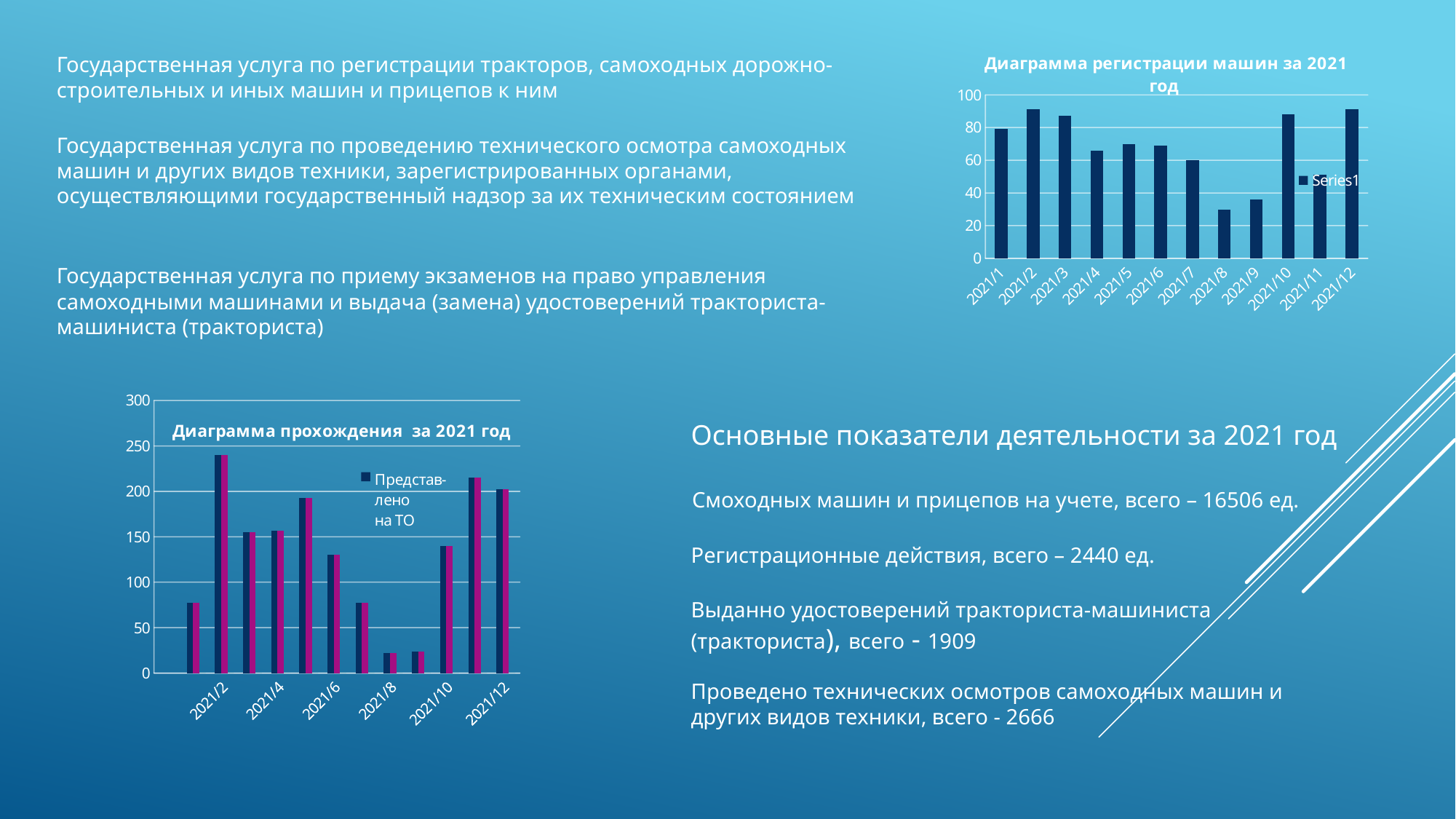
How many series does the legend of the 'Диаграмма регистрации машин за 2021 год' chart list? 1 What kind of chart is the 'Диаграмма прохождения за 2021 год' chart? bar chart In the 'Диаграмма регистрации машин за 2021 год' chart, which month has the lowest value? 2021/8 What legend entry is shown on the 'Диаграмма прохождения за 2021 год' chart? Представ-лено на ТО In the 'Диаграмма регистрации машин за 2021 год' chart, is the value for 2021/9 greater or less than 40? less In the 'Диаграмма прохождения за 2021 год' chart, is the value of the magenta bar for 2021/2 greater or less than 200? greater What kind of chart is the 'Диаграмма регистрации машин за 2021 год' chart? bar chart What is the legend entry of the 'Диаграмма регистрации машин за 2021 год' chart? Series1 In the 'Диаграмма регистрации машин за 2021 год' chart, which is larger, the value for 2021/3 or the value for 2021/7? 2021/3 How many categories are shown on the x axis of the 'Диаграмма регистрации машин за 2021 год' chart? 12 In the 'Диаграмма прохождения за 2021 год' chart, is the value of the magenta bar for 2021/8 greater or less than 50? less